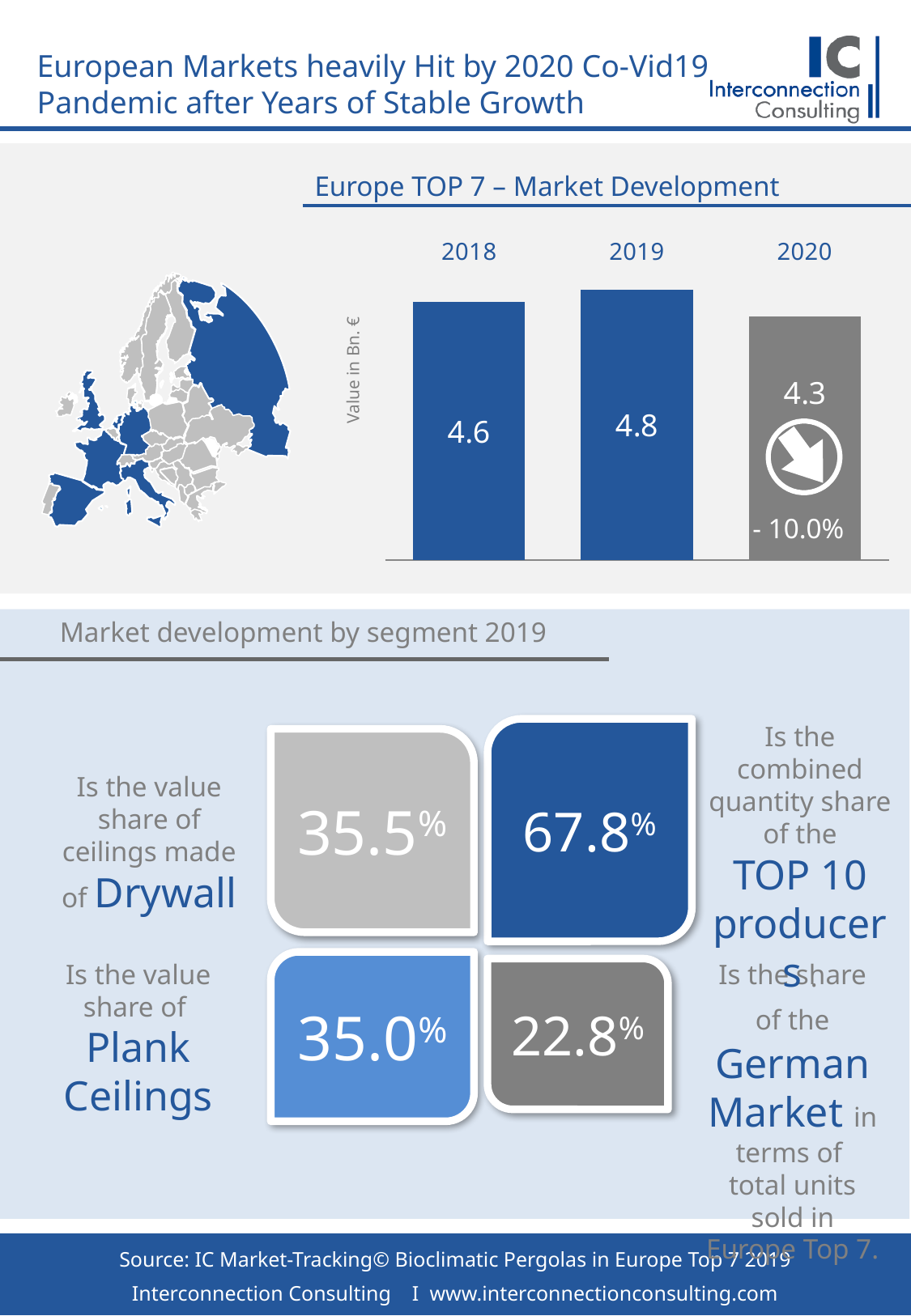
What kind of chart is the Europe TOP 7 – Market Development chart? bar chart In the Europe TOP 7 – Market Development chart, what is the difference between the 2019 and 2020 values? 0.5 In the Europe TOP 7 – Market Development chart, what is the value for 2019? 4.8 In the Europe TOP 7 – Market Development chart, what is the value for 2020? 4.3 In the Europe TOP 7 – Market Development chart, what is the value for 2018? 4.6 How many years are shown in the Europe TOP 7 – Market Development chart? 3 In the Europe TOP 7 – Market Development chart, does the value rise or fall from 2019 to 2020? fall What percentage change is printed on the 2020 bar of the Europe TOP 7 – Market Development chart? - 10.0% In the Europe TOP 7 – Market Development chart, which year has the highest value? 2019 In the Europe TOP 7 – Market Development chart, which is larger, the value for 2018 or for 2020? 2018 In the Europe TOP 7 – Market Development chart, which year has the lowest value? 2020 In the Europe TOP 7 – Market Development chart, what is the difference between the 2019 and 2018 values? 0.2